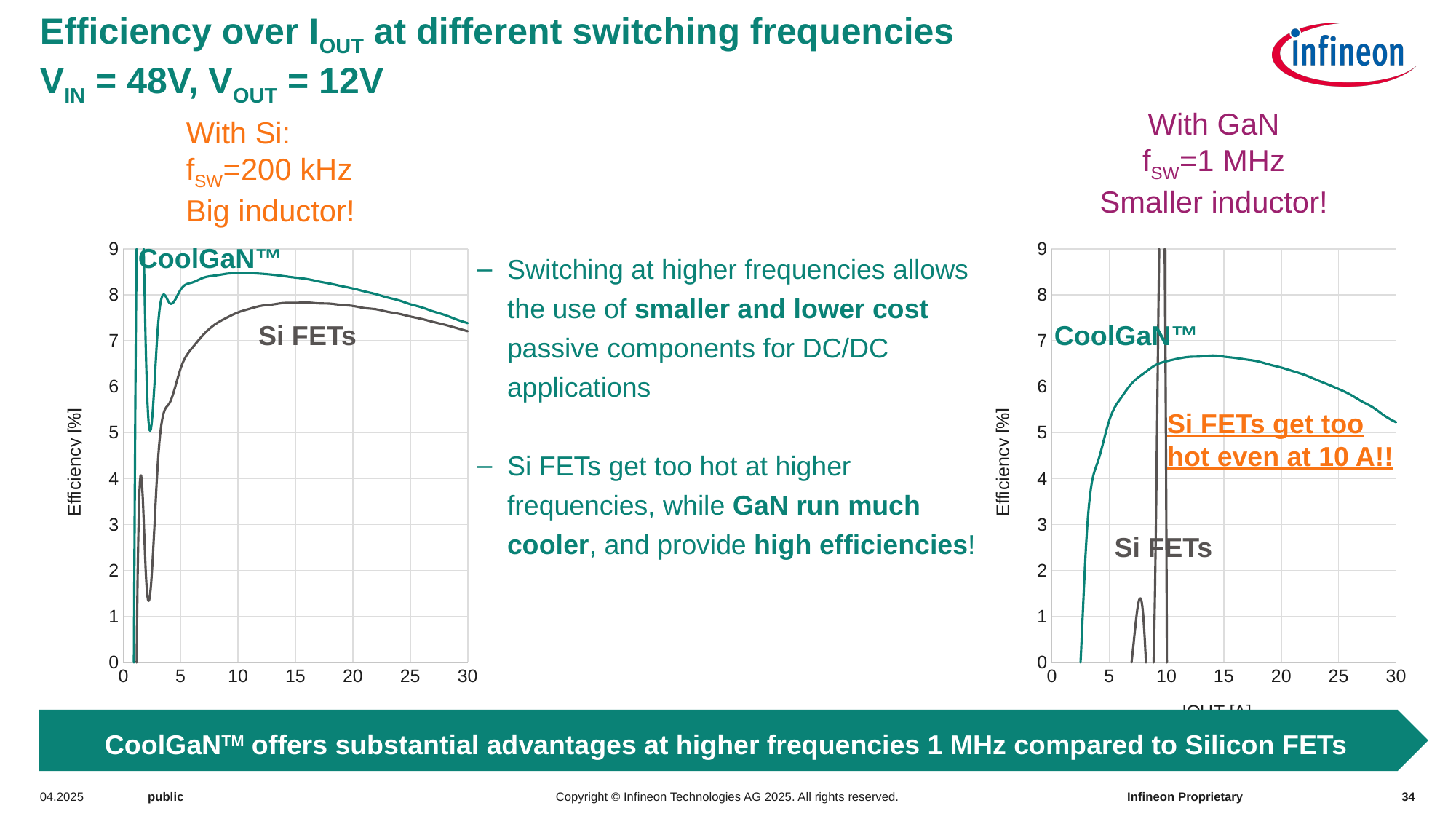
On the left chart (fSW=200 kHz), is the Si FETs value at 15 A greater or less than 8? less On the left chart (fSW=200 kHz), does the Si FETs curve rise or fall between 5 A and 15 A? rise How many series are plotted on the right chart (fSW=1 MHz)? 2 On the left chart (fSW=200 kHz), is the CoolGaN value at 10 A greater or less than 8? greater On the right chart (fSW=1 MHz), is the CoolGaN value at 10 A greater or less than 6? greater On the right chart (fSW=1 MHz), does the CoolGaN curve rise or fall between 15 A and 30 A? fall On the left chart (fSW=200 kHz), which series has the higher efficiency at 10 A, CoolGaN or Si FETs? CoolGaN What switching frequency is stated above the right chart? 1 MHz What is the y-axis label on the left chart? Efficiency [%] What kind of chart is the left chart (fSW=200 kHz)? line chart